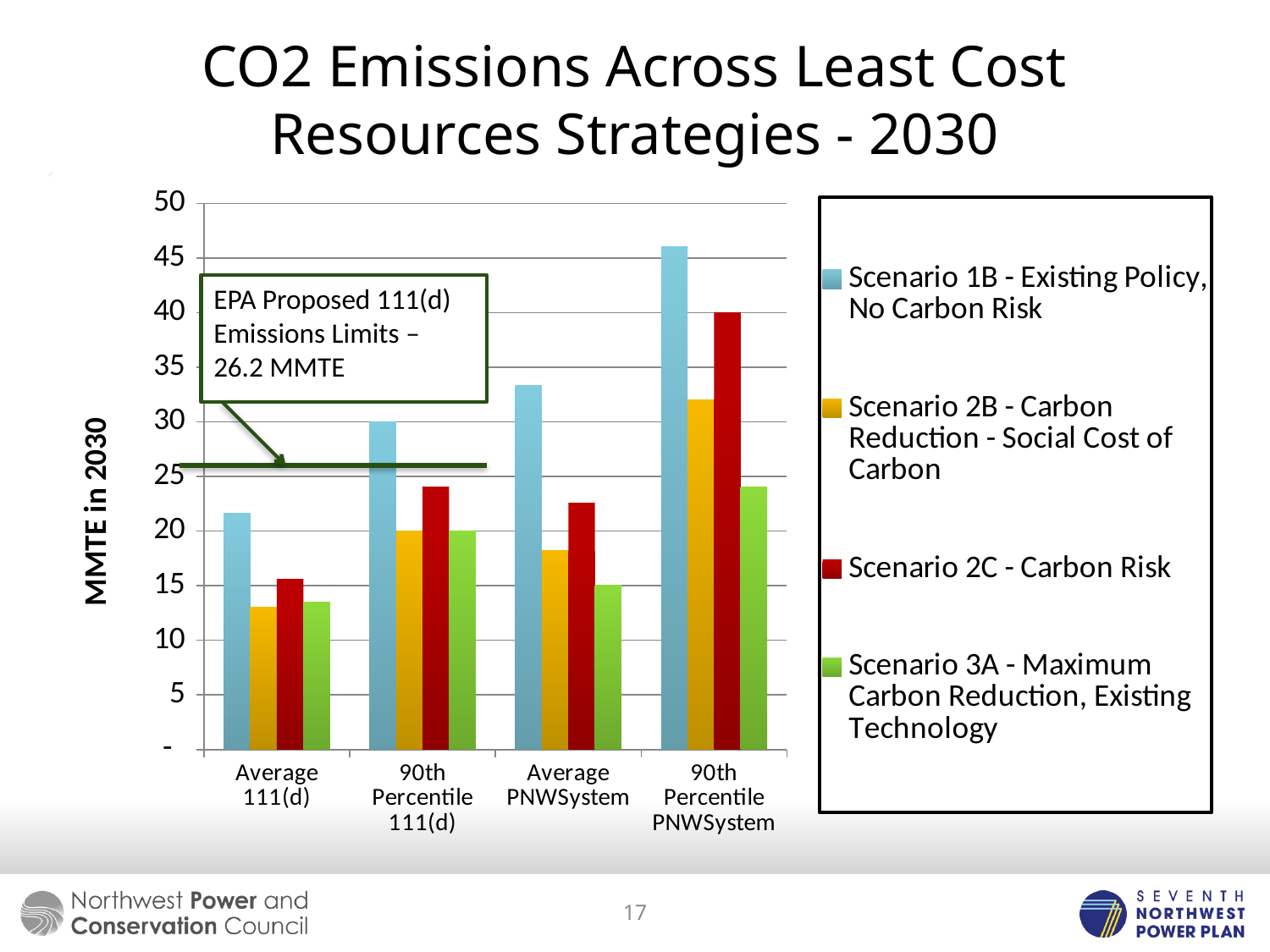
Is the value for Scenario 2C in the Average 111(d) category greater or less than 20? less How many categories are shown along the x axis of the chart? 4 In the Average PNWSystem category, which scenario has the lowest bar? Scenario 3A - Maximum Carbon Reduction, Existing Technology Is the value for Scenario 1B in the Average PNWSystem category greater or less than 30? greater Is the value for Scenario 3A in the 90th Percentile PNWSystem category greater or less than 20? greater Which scenario has the highest emissions in every category? Scenario 1B - Existing Policy, No Carbon Risk What kind of chart is shown on the slide? Bar chart Which category has the tallest bar in the chart? 90th Percentile PNWSystem In the 90th Percentile PNWSystem category, which is larger: Scenario 2B or Scenario 2C? Scenario 2C How many series does the chart's legend list? 4 Do the values for Scenario 1B rise or fall moving left to right across the categories? Rise What EPA proposed 111(d) emissions limit is annotated on the chart? 26.2 MMTE